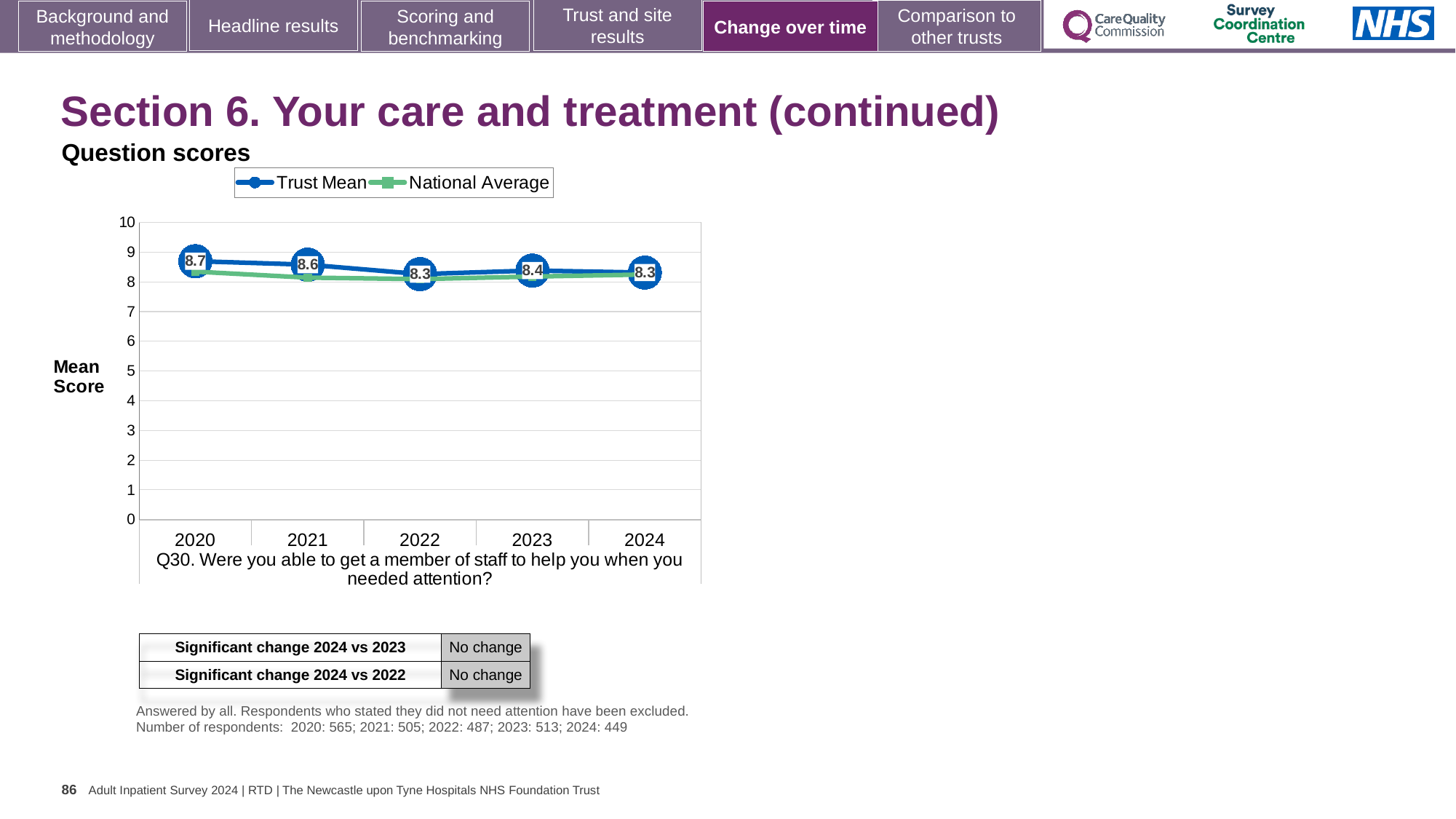
Is the National Average value for 2020 greater or less than 5? greater How many years are plotted on the x axis? 5 What is the Trust Mean score for 2023? 8.4 What is the Trust Mean score for 2022? 8.3 Which is larger, the Trust Mean score for 2020 or for 2022? 2020 What kind of chart is shown? Line chart What is the difference between the Trust Mean score in 2020 and in 2024? 0.4 In which year is the Trust Mean score highest? 2020 How many series does the legend list? 2 What is the Trust Mean score for 2020? 8.7 What is the Trust Mean score for 2024? 8.3 Does the Trust Mean score rise or fall from 2020 to 2024? Fall